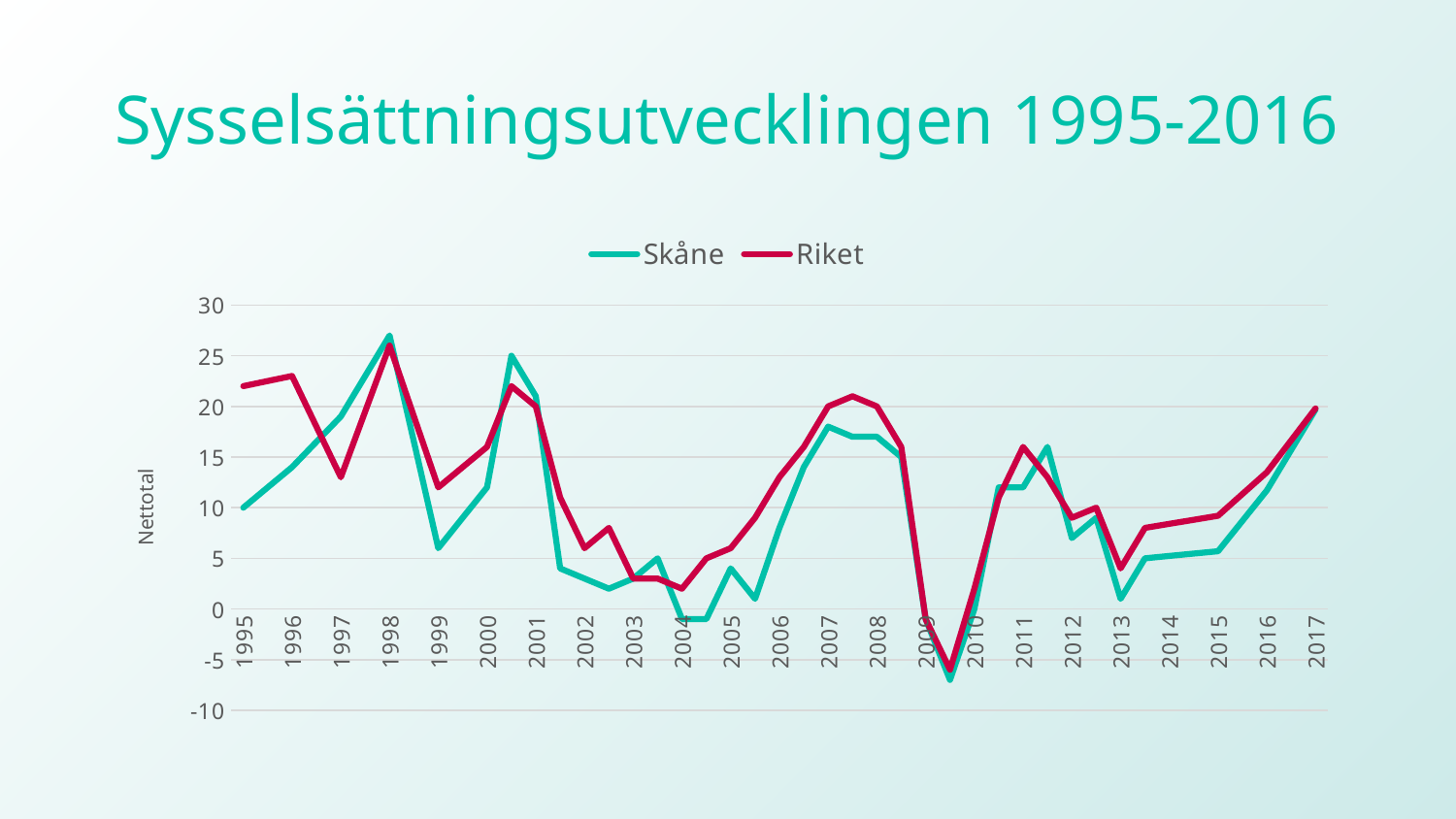
What is the title of the chart? Sysselsättningsutvecklingen 1995-2016 In which year does the Skåne line reach its highest value? 1998 Does the Skåne line rise or fall from 2013 to 2017? rise How many series does the legend list? 2 Is the value for Riket in 1995 greater or less than 20? greater In which year does the Riket line reach its highest value? 1998 What kind of chart is shown on the slide? line chart In 1995, which series has the higher value, Skåne or Riket? Riket In which year does the Skåne line reach its lowest value? 2009 What is the label on the vertical axis? Nettotal